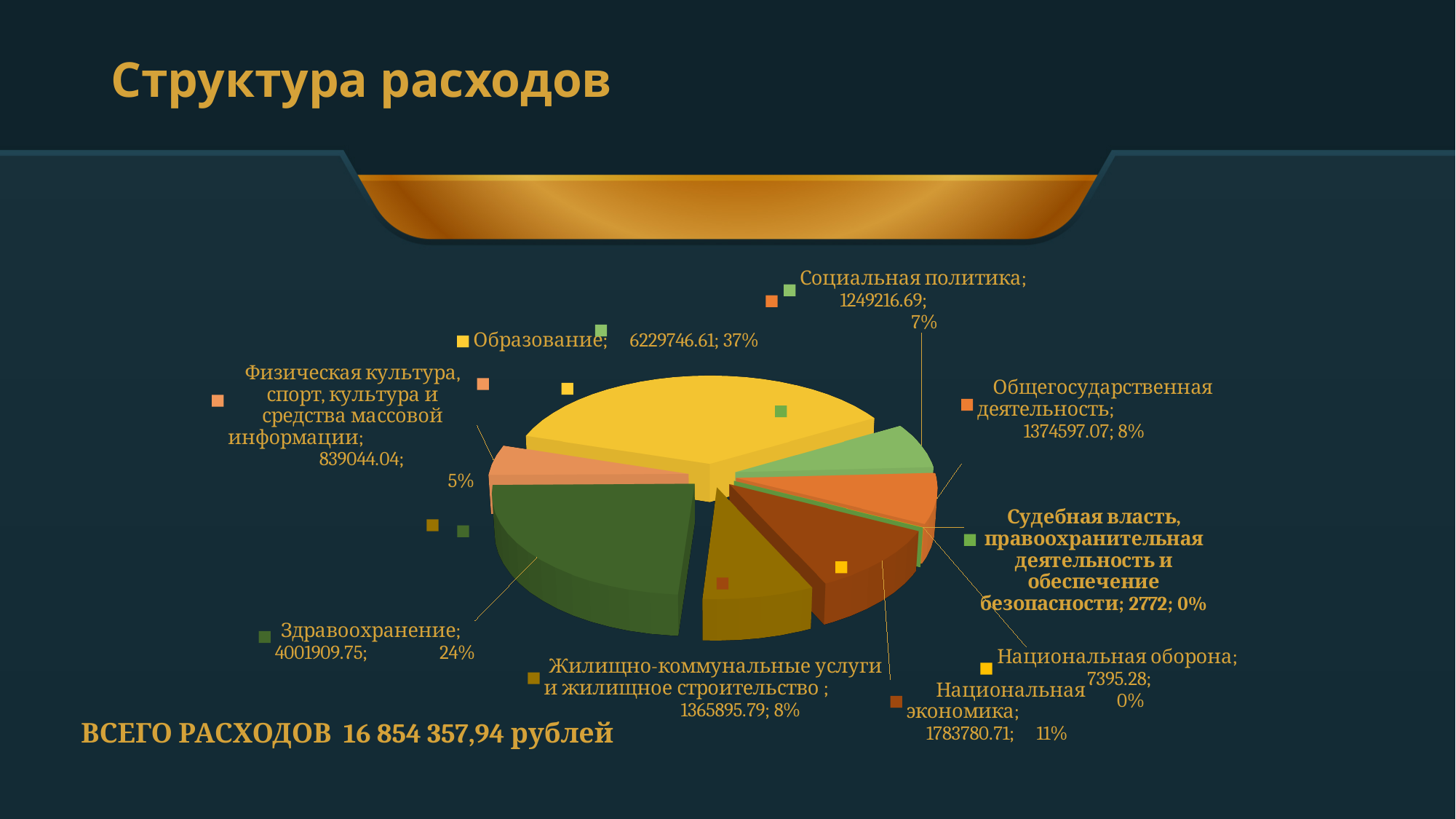
What kind of chart is shown on the slide? Pie chart Which is larger: the value for Общегосударственная деятельность or the value for Жилищно-коммунальные услуги и жилищное строительство? Общегосударственная деятельность What is the value shown for Образование? 6229746.61 Which category has the smallest value in the chart? Судебная власть, правоохранительная деятельность и обеспечение безопасности How many categories are shown in the pie chart? 9 What percentage share is shown for Социальная политика? 7% What is the value shown for Национальная экономика? 1783780.71 What is the value shown for Национальная оборона? 7395.28 What is the difference between the values for Здравоохранение and Национальная экономика? 2218129.04 Which category has the largest share of the pie? Образование What percentage share is shown for Здравоохранение? 24% What is the title of the slide containing the chart? Структура расходов